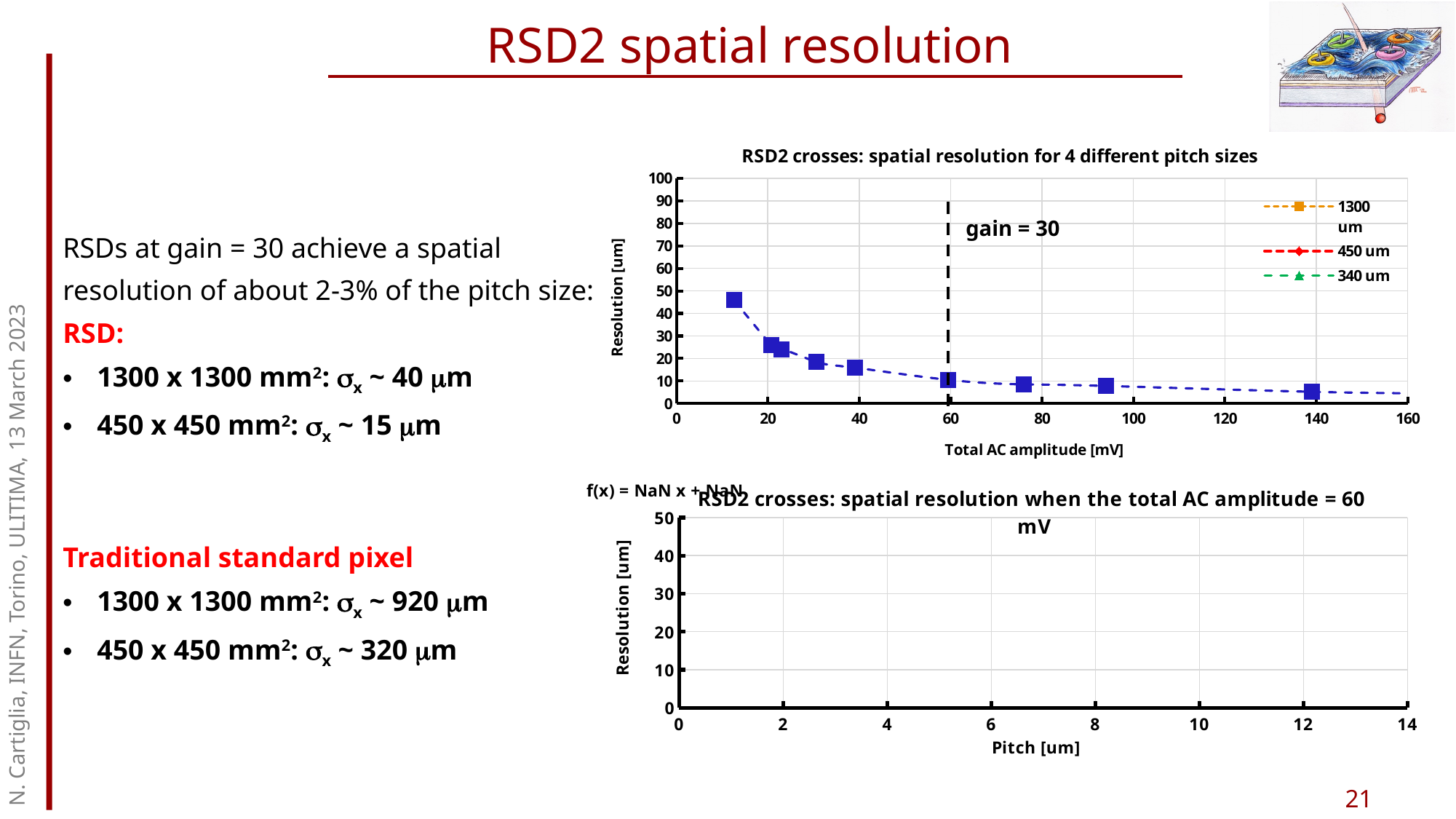
In the top chart, what is the label of the x axis? Total AC amplitude [mV] In the top chart titled 'RSD2 crosses: spatial resolution for 4 different pitch sizes', what kind of chart is shown? Scatter plot In the top chart, is the resolution value at a total AC amplitude of about 40 mV greater or less than 10? greater In the top chart, do the resolution values rise or fall as the total AC amplitude increases? Fall In the bottom chart titled 'RSD2 crosses: spatial resolution when the total AC amplitude = 60 mV', how many data points are plotted? 0 In the top chart, is the resolution value for the leftmost point (at about 12 mV) greater or less than 40? greater In the top chart, what total AC amplitude does the dashed vertical line labelled 'gain = 30' mark? 60 In the top chart, is the resolution value for the rightmost point (at about 140 mV) greater or less than 10? less In the top chart, how many series does the legend list? 3 In the top chart, which point has the highest resolution value: the one at about 12 mV or the one at about 140 mV? The one at about 12 mV